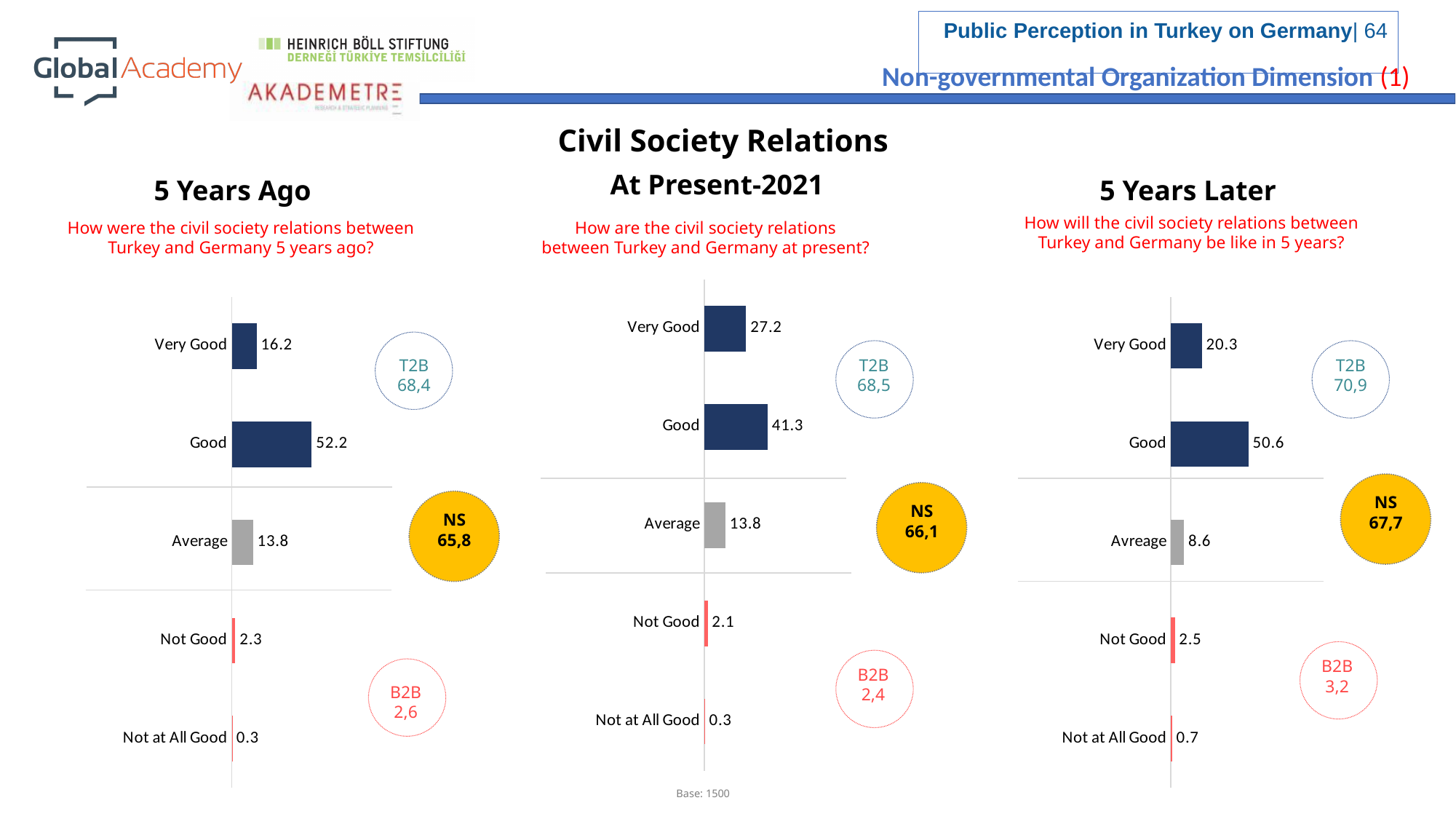
In the '5 Years Later' chart, what is the value for Average? 8.6 How many categories are shown in the '5 Years Ago' chart? 5 What is the NS value shown next to the 'At Present-2021' chart? 66,1 In the '5 Years Ago' chart, which category has the lowest value? Not at All Good In the '5 Years Later' chart, what is the value for Not at All Good? 0.7 In the '5 Years Later' chart, what is the difference between the values for Good and Very Good? 30.3 What kind of chart is the 'At Present-2021' chart? Bar chart What is the T2B value shown next to the '5 Years Later' chart? 70,9 In the 'At Present-2021' chart, which category has the highest value? Good In the '5 Years Ago' chart, what is the value for Good? 52.2 In the 'At Present-2021' chart, which is larger: the value for Average or the value for Not Good? Average In the 'At Present-2021' chart, what is the value for Very Good? 27.2